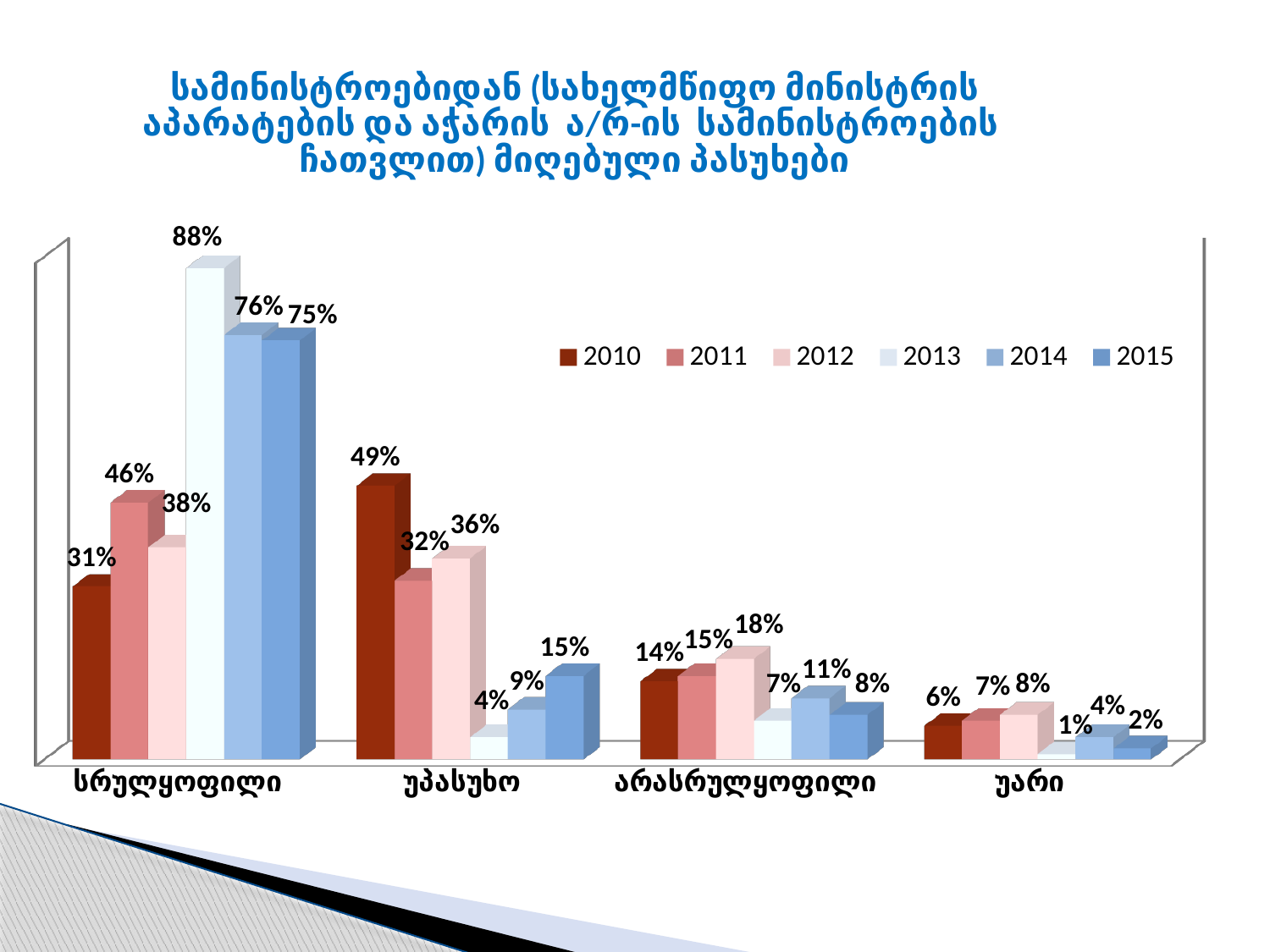
What is the difference between the 2014 and 2015 values in the სრულყოფილი category? 1% Which year has the highest value in the სრულყოფილი category? 2013 How many series does the legend list? 6 How many categories are shown on the x axis? 4 What is the value for 2013 in the უარი category? 1% Which is larger in the უპასუხო category: the value for 2011 or the value for 2012? 2012 Which year is shown in the darkest red colour in the legend? 2010 What kind of chart is shown on the slide? Bar chart Which year has the lowest value in the უპასუხო category? 2013 What is the value for 2012 in the არასრულყოფილი category? 18% What is the value for 2010 in the უპასუხო category? 49% What is the value for 2013 in the სრულყოფილი category? 88%